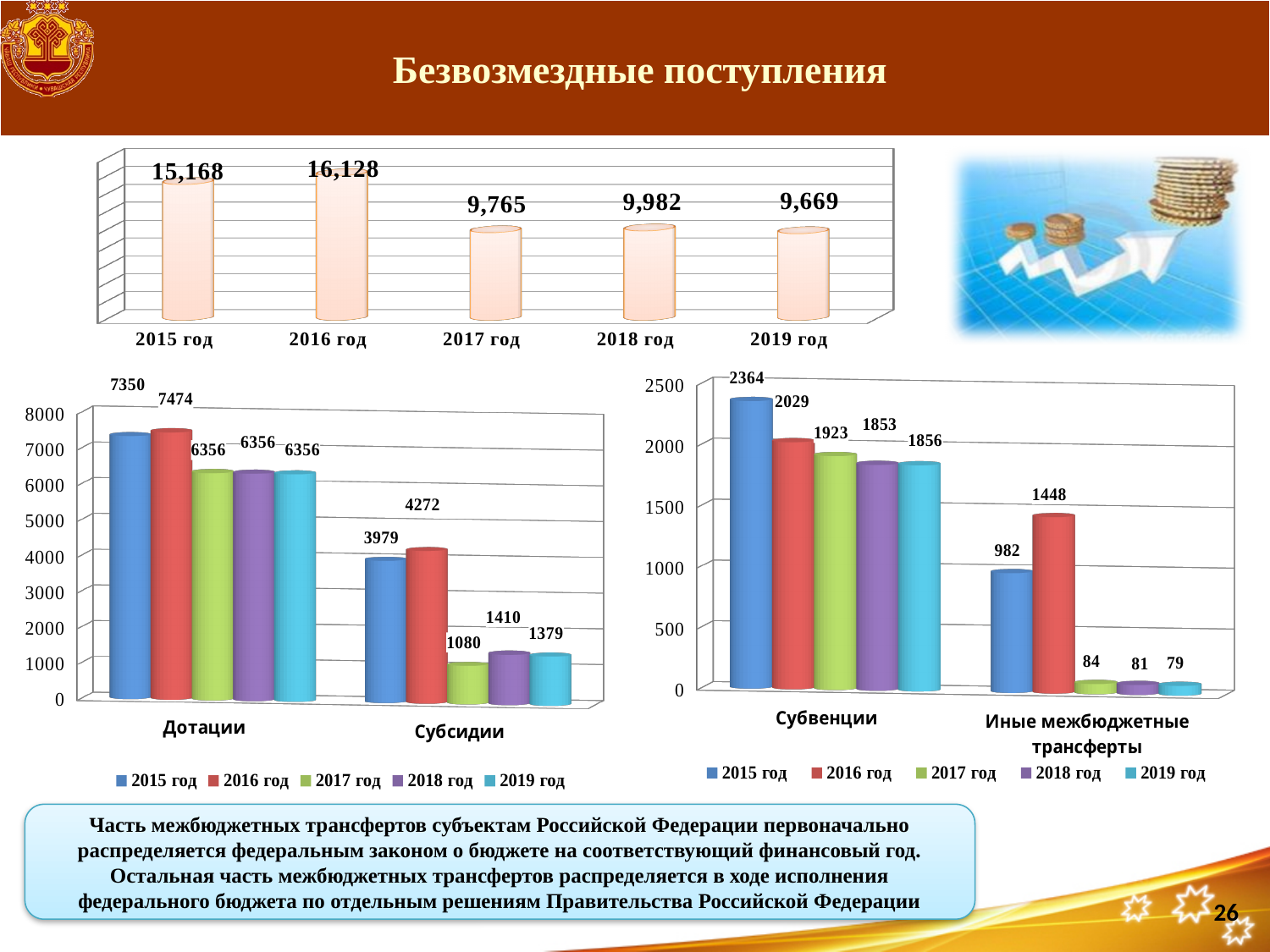
In the bottom-left chart, what is the value for Дотации in 2019 год? 6356 In the top chart, how many years are shown? 5 What kind of chart is the bottom-right chart? Bar chart In the bottom-right chart, what is the value for Иные межбюджетные трансферты in 2016 год? 1448 In the bottom-left chart, how many series does the legend list? 5 In the top chart, what is the difference between the values for 2016 год and 2015 год? 960 In the bottom-left chart, which year has the highest value for Дотации? 2016 год In the top chart, which year has the lowest value? 2019 год In the top chart, what is the value for 2016 год? 16,128 In the bottom-right chart, what is the difference between Субвенции in 2015 год and 2016 год? 335 In the bottom-right chart, which year has the lowest value for Иные межбюджетные трансферты? 2019 год In the bottom-left chart, what is the value for Субсидии in 2016 год? 4272